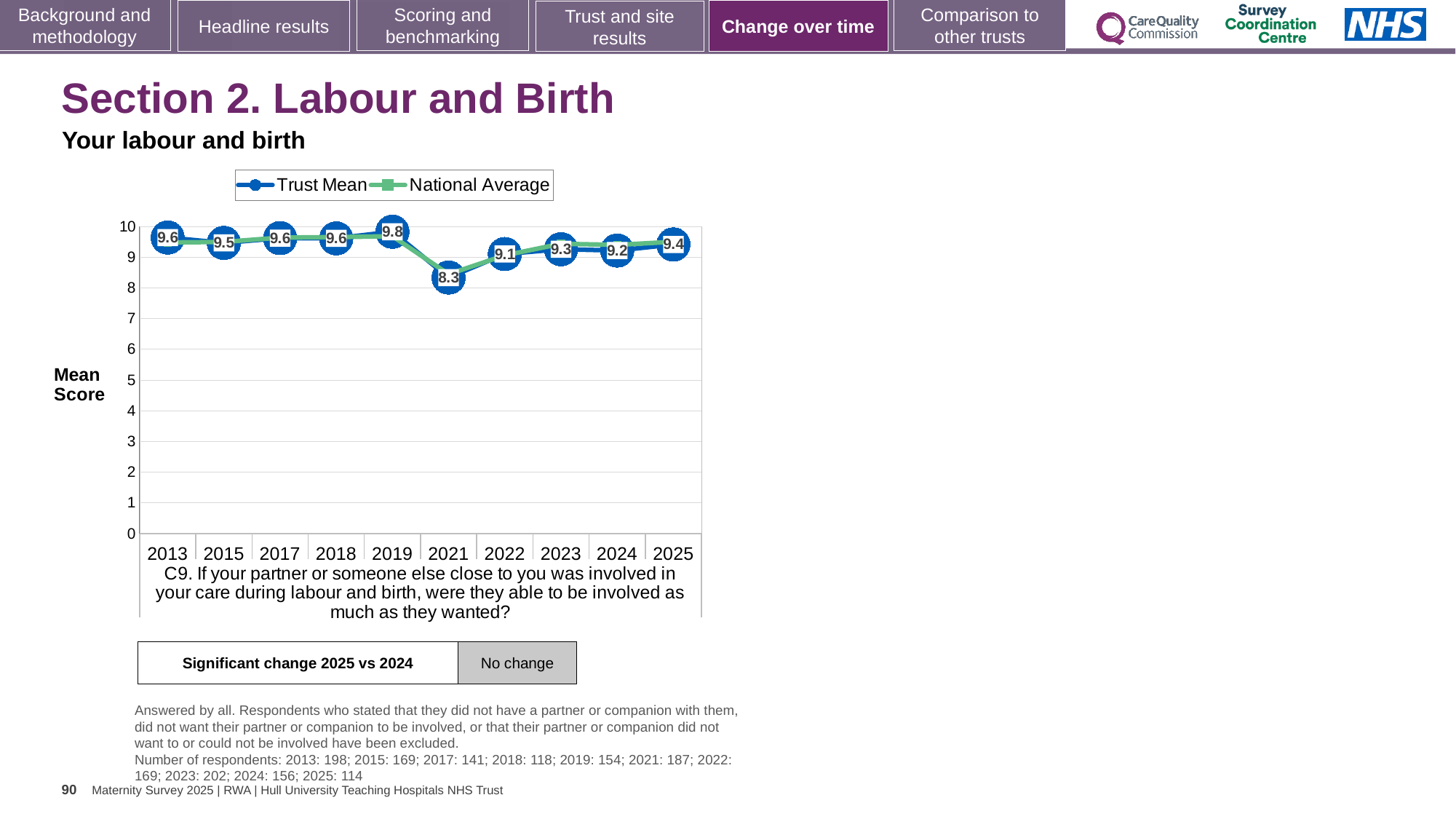
Which year has the lowest Trust Mean? 2021 What is the Trust Mean for 2015? 9.5 Which is larger, the Trust Mean for 2024 or for 2025? 2025 What is the difference between the Trust Mean in 2019 and in 2021? 1.5 What is the Trust Mean for 2025? 9.4 What is the Trust Mean for 2019? 9.8 What kind of chart is shown on the slide? line chart Which year has the highest Trust Mean? 2019 How many years are plotted on the x axis? 10 Is the Trust Mean for 2022 greater or less than 9? greater What is the Trust Mean for 2021? 8.3 How many series does the legend list? 2